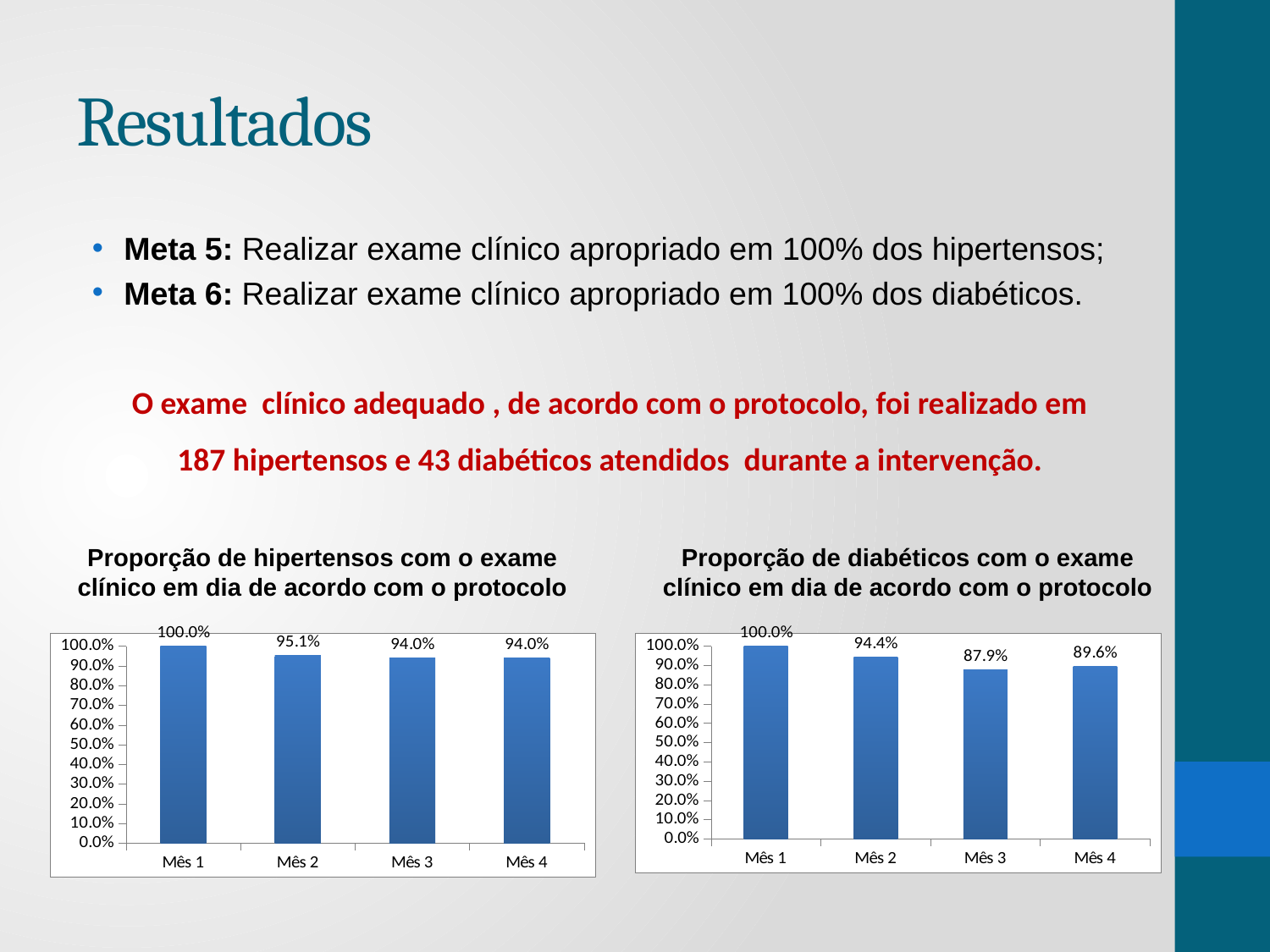
In the chart 'Proporção de hipertensos com o exame clínico em dia de acordo com o protocolo', do the values rise or fall from Mês 1 to Mês 3? Fall In the chart 'Proporção de diabéticos com o exame clínico em dia de acordo com o protocolo', what is the difference between the values for Mês 1 and Mês 3? 12.1% In the chart 'Proporção de diabéticos com o exame clínico em dia de acordo com o protocolo', what is the value for Mês 3? 87.9% Which is larger: the value for Mês 2 in the hipertensos chart (left) or the value for Mês 2 in the diabéticos chart (right)? Mês 2 in the hipertensos chart (95.1%) In the chart 'Proporção de diabéticos com o exame clínico em dia de acordo com o protocolo', what is the value for Mês 4? 89.6% In the chart 'Proporção de diabéticos com o exame clínico em dia de acordo com o protocolo', which month has the lowest value? Mês 3 How many months are shown on the x axis of the chart 'Proporção de hipertensos com o exame clínico em dia de acordo com o protocolo'? 4 In the chart 'Proporção de hipertensos com o exame clínico em dia de acordo com o protocolo', what is the difference between the values for Mês 1 and Mês 2? 4.9% In the chart 'Proporção de diabéticos com o exame clínico em dia de acordo com o protocolo', is the value for Mês 4 greater or less than 90.0%? less In the chart 'Proporção de hipertensos com o exame clínico em dia de acordo com o protocolo', which month has the highest value? Mês 1 In the chart 'Proporção de hipertensos com o exame clínico em dia de acordo com o protocolo', what is the value for Mês 2? 95.1% What kind of chart is 'Proporção de diabéticos com o exame clínico em dia de acordo com o protocolo'? Bar chart